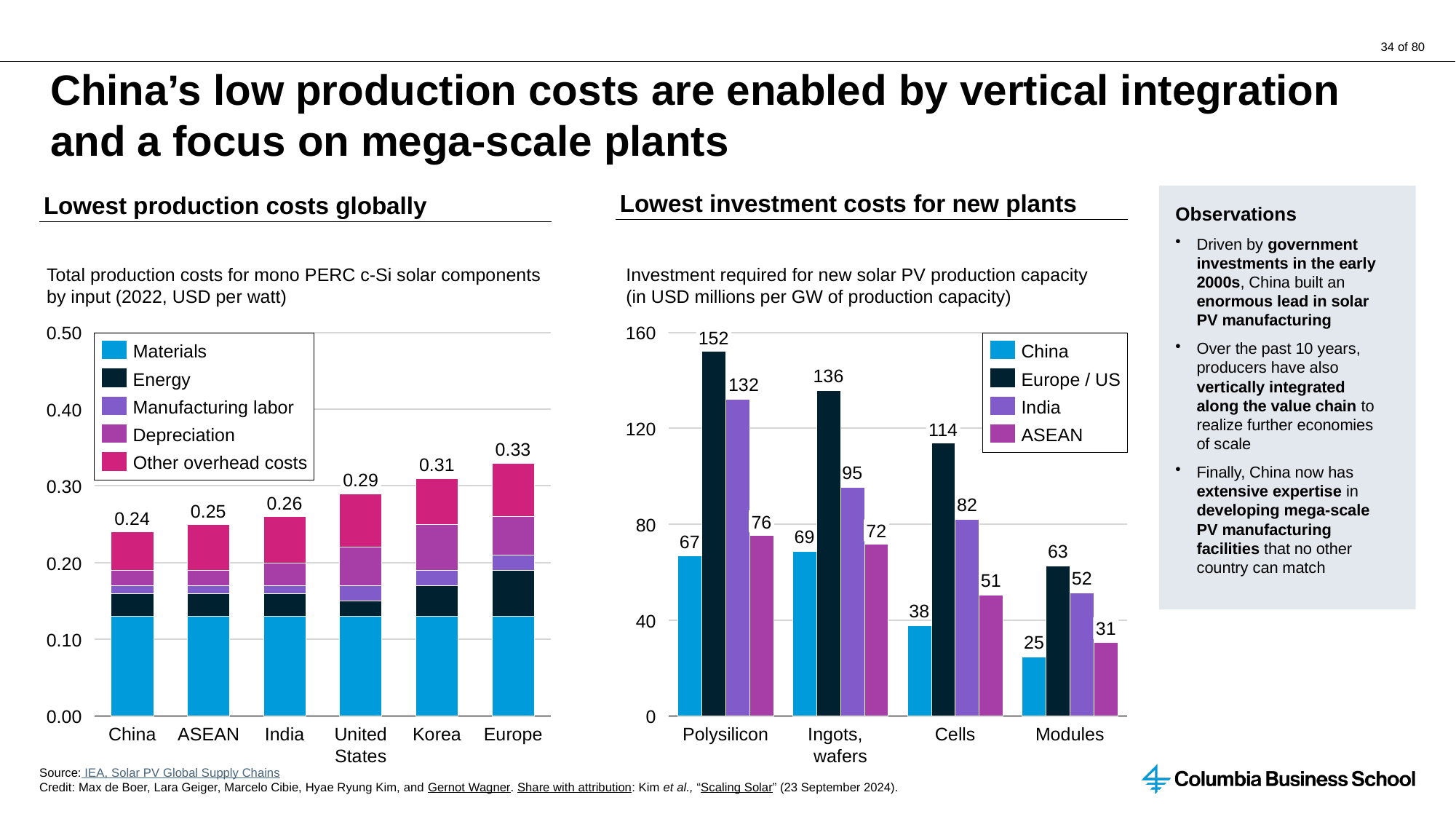
In the 'Lowest production costs globally' chart, how many countries or regions are shown on the x axis? 6 In the 'Lowest investment costs for new plants' chart, what is the value for Europe / US for Polysilicon? 152 In the 'Lowest investment costs for new plants' chart, what is the difference between the India and ASEAN values for Ingots, wafers? 23 What kind of chart is the 'Lowest investment costs for new plants' chart? bar chart In the 'Lowest investment costs for new plants' chart, which is larger for Modules: the India value or the ASEAN value? India In the 'Lowest production costs globally' chart, what is the total production cost for China? 0.24 In the 'Lowest production costs globally' chart, how many series does the legend list? 5 In the 'Lowest production costs globally' chart, what is the difference between the total for Europe and the total for China? 0.09 In the 'Lowest investment costs for new plants' chart, what is the value for China for Modules? 25 In the 'Lowest production costs globally' chart, do the total production costs rise or fall from China to Europe along the x axis? rise In the 'Lowest production costs globally' chart, which country has the highest total production cost? Europe In the 'Lowest investment costs for new plants' chart, which region has the lowest value for Cells? China